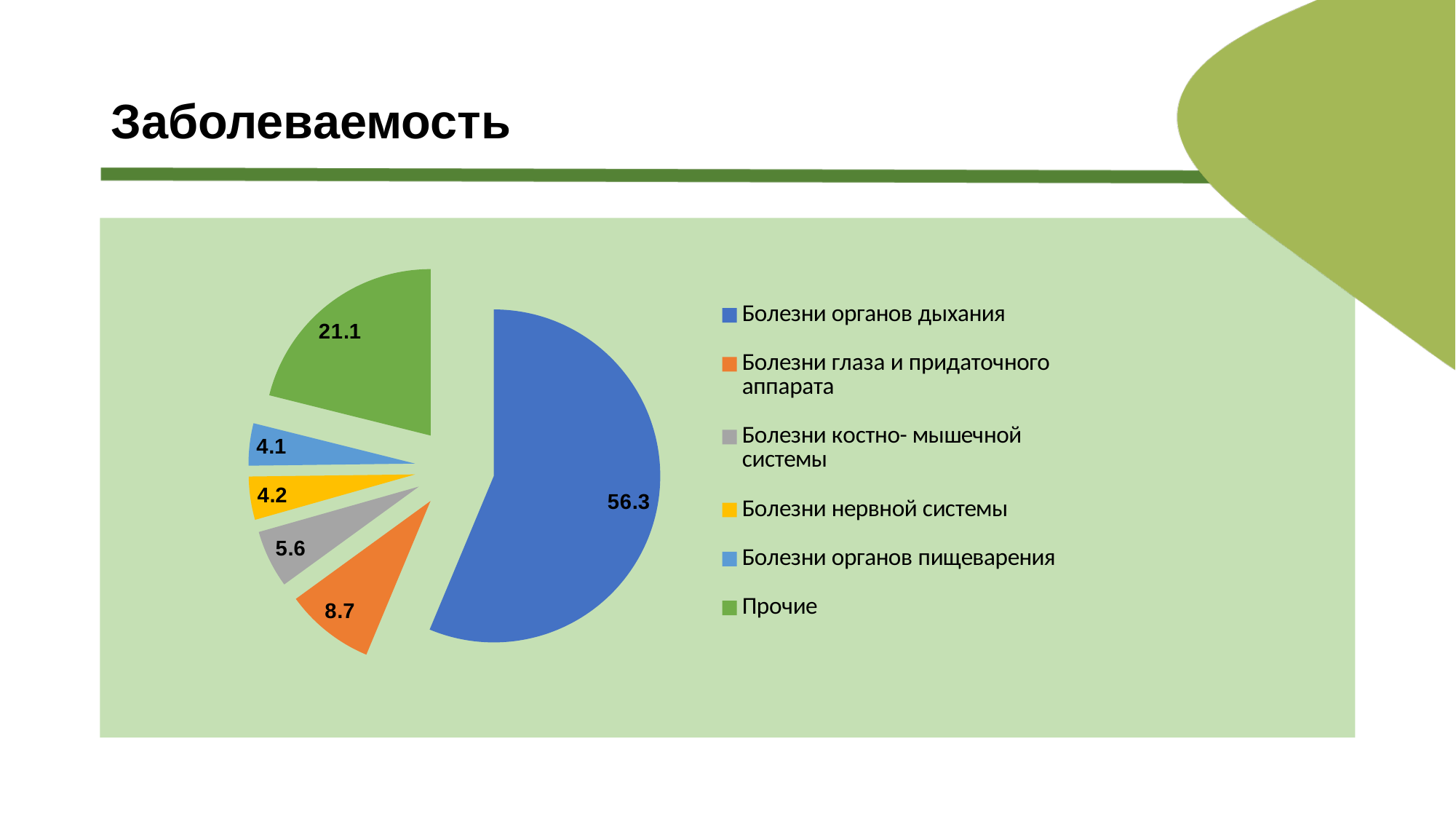
What is the value for Болезни костно- мышечной системы? 5.6 Which category has the largest slice of the pie? Болезни органов дыхания How many slices does the pie chart have? 6 Which is larger, the value for Болезни глаза и придаточного аппарата or the value for Болезни костно- мышечной системы? Болезни глаза и придаточного аппарата What is the value for Болезни органов дыхания? 56.3 What is the value for Болезни нервной системы? 4.2 What colour is the slice for Прочие? green What is the value for Болезни глаза и придаточного аппарата? 8.7 What is the title of the slide containing the chart? Заболеваемость What is the value for Прочие? 21.1 What type of chart is shown on the slide? pie chart What is the difference between the values for Болезни органов дыхания and Прочие? 35.2